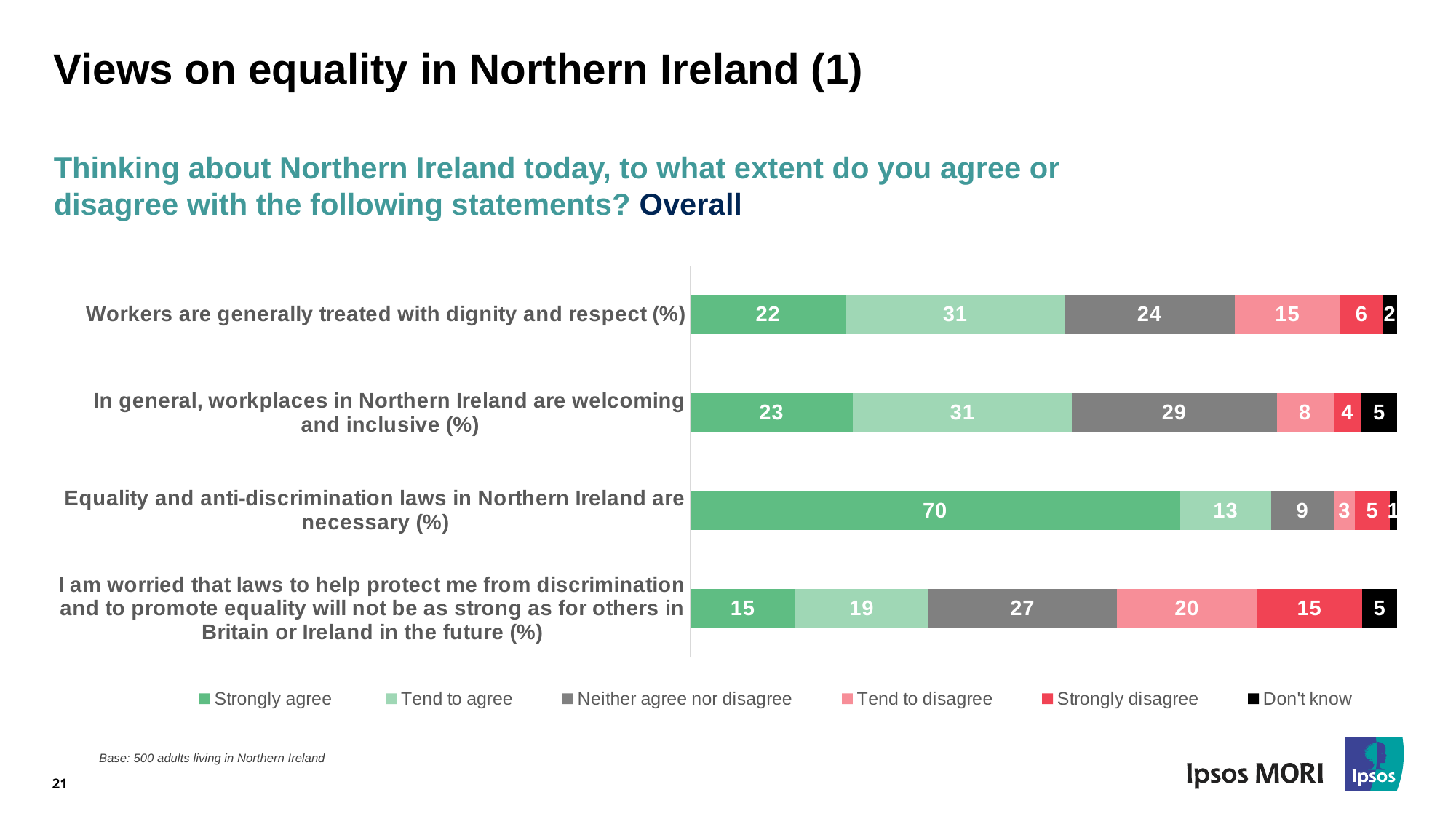
How many statements are shown in the chart? 4 What kind of chart is shown on the slide? Stacked bar chart Which statement has the lowest 'Neither agree nor disagree' percentage? Equality and anti-discrimination laws in Northern Ireland are necessary Which is larger: the 'Tend to disagree' percentage for 'Workers are generally treated with dignity and respect' or for 'In general, workplaces in Northern Ireland are welcoming and inclusive'? Workers are generally treated with dignity and respect What percentage tend to agree that workers are generally treated with dignity and respect? 31 What percentage answered 'Don't know' for the statement that workplaces in Northern Ireland are welcoming and inclusive? 5 How many series does the legend list? 6 What is the difference between the 'Strongly agree' percentage for 'Equality and anti-discrimination laws in Northern Ireland are necessary' and for 'Workers are generally treated with dignity and respect'? 48 What percentage strongly disagree with the statement 'I am worried that laws to help protect me from discrimination and to promote equality will not be as strong as for others in Britain or Ireland in the future'? 15 What is the combined percentage of 'Strongly agree' and 'Tend to agree' for 'In general, workplaces in Northern Ireland are welcoming and inclusive'? 54 What percentage strongly agree that equality and anti-discrimination laws in Northern Ireland are necessary? 70 Which statement has the highest 'Strongly agree' percentage? Equality and anti-discrimination laws in Northern Ireland are necessary